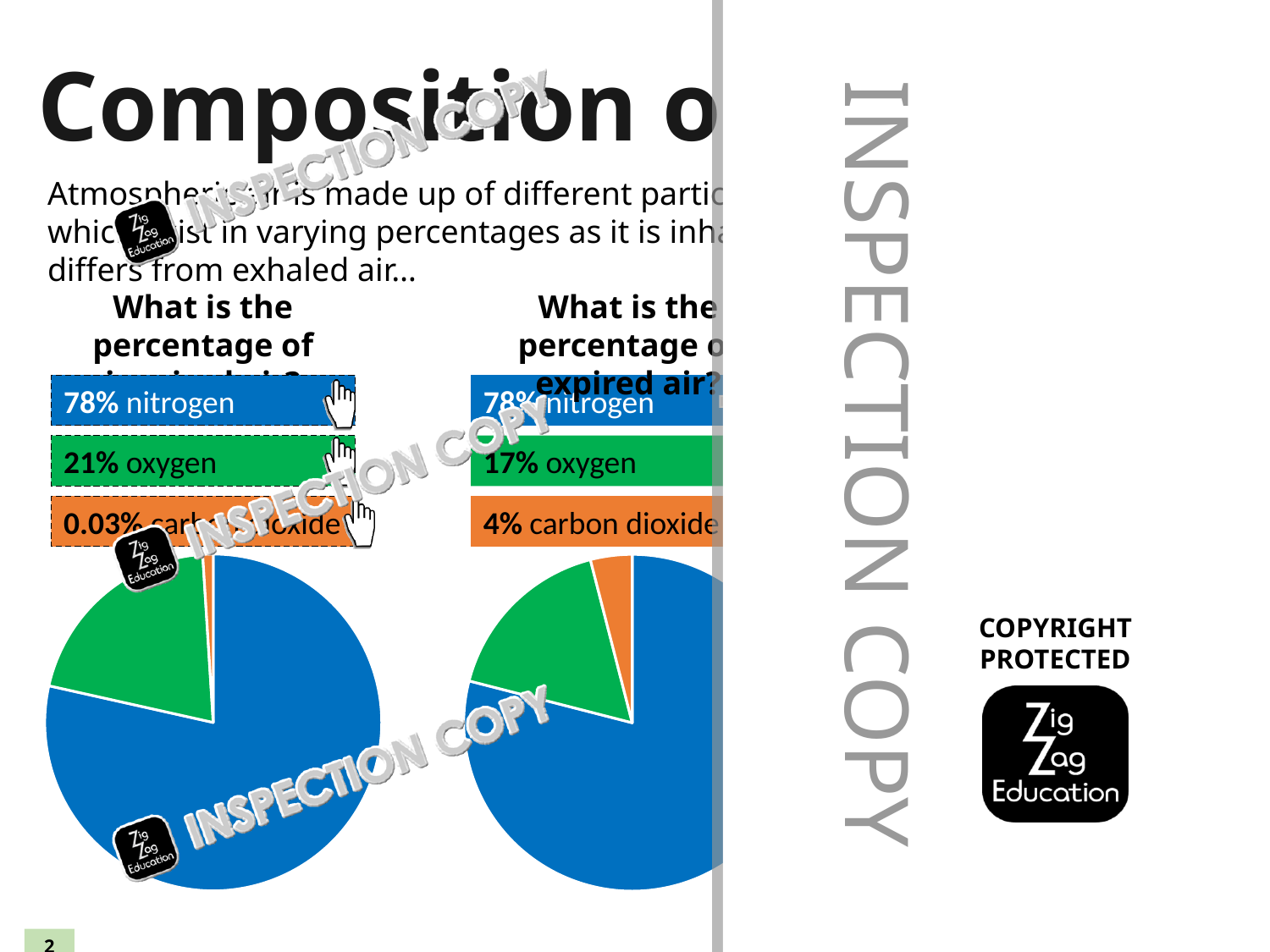
In the left pie chart (inspired air), which gas has the smallest share? carbon dioxide How many slices does the right pie chart (expired air) have? 3 Which is larger: the carbon dioxide share in the left pie chart (inspired air) or in the right pie chart (expired air)? right (expired air) In the left pie chart (inspired air), what percentage is oxygen? 21% In the right pie chart (expired air), what percentage is oxygen? 17% In the right pie chart (expired air), what percentage is carbon dioxide? 4% What is the difference between the oxygen percentage in the left pie chart (inspired air) and the right pie chart (expired air)? 4% In the right pie chart (expired air), which gas has the largest share? nitrogen What kind of chart is shown on the left of the slide? pie chart In the left pie chart (inspired air), what percentage is carbon dioxide? 0.03% What colour represents oxygen in the pie charts? green In the left pie chart (inspired air), what percentage is nitrogen? 78%